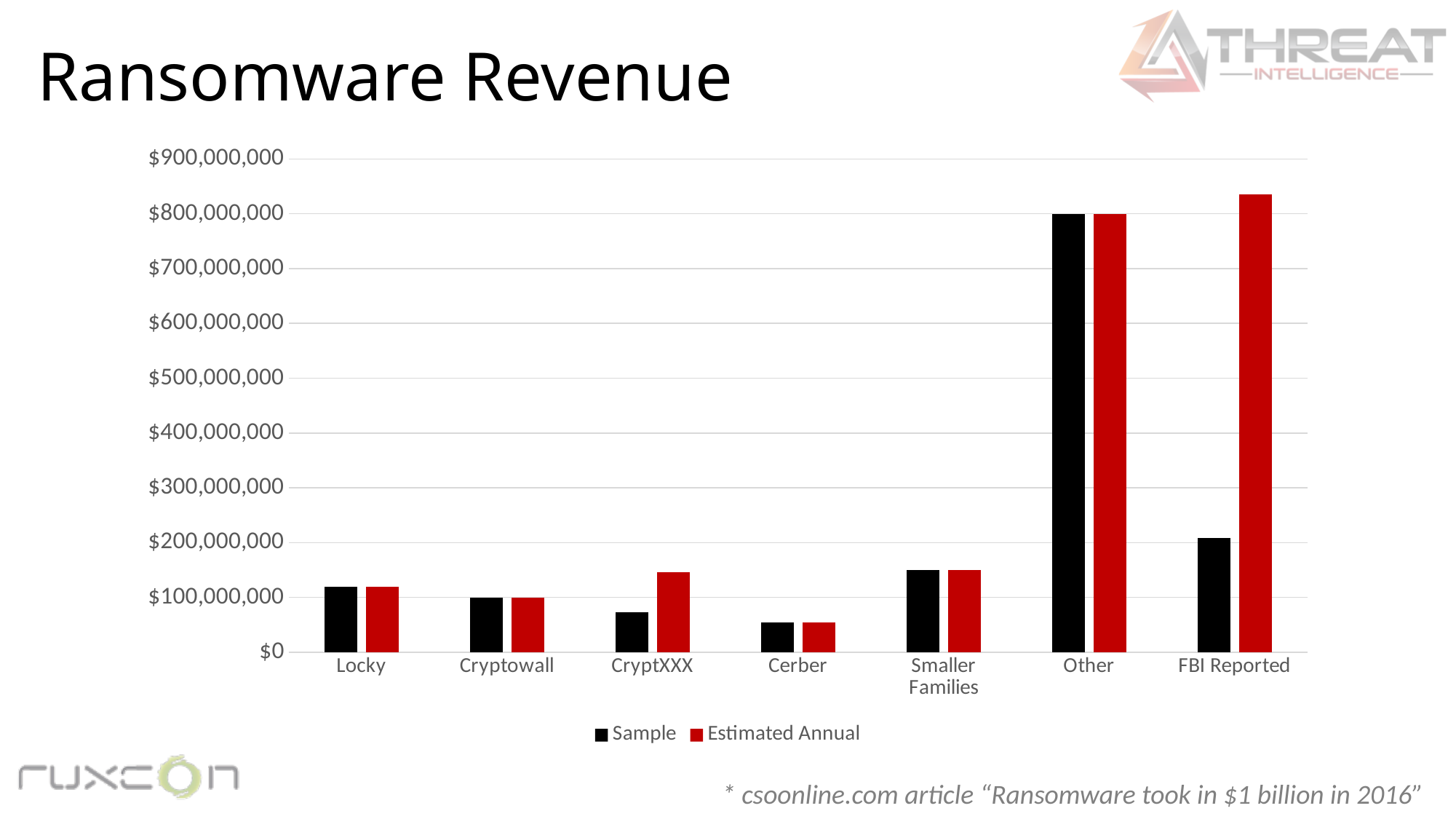
How many series does the legend list? 2 What colour are the Estimated Annual bars? red Which category has the lowest Sample value? Cerber Which category has the highest Estimated Annual value? FBI Reported What kind of chart is shown on the slide? bar chart Is the Sample value for Locky greater or less than $100,000,000? greater Which category has the highest Sample value? Other Which is larger: the Sample value for Other or the Sample value for FBI Reported? Other For CryptXXX, which is larger: the Sample value or the Estimated Annual value? Estimated Annual Is the Sample value for CryptXXX greater or less than $100,000,000? less How many categories are shown on the x axis? 7 Is the Estimated Annual value for FBI Reported greater or less than $800,000,000? greater